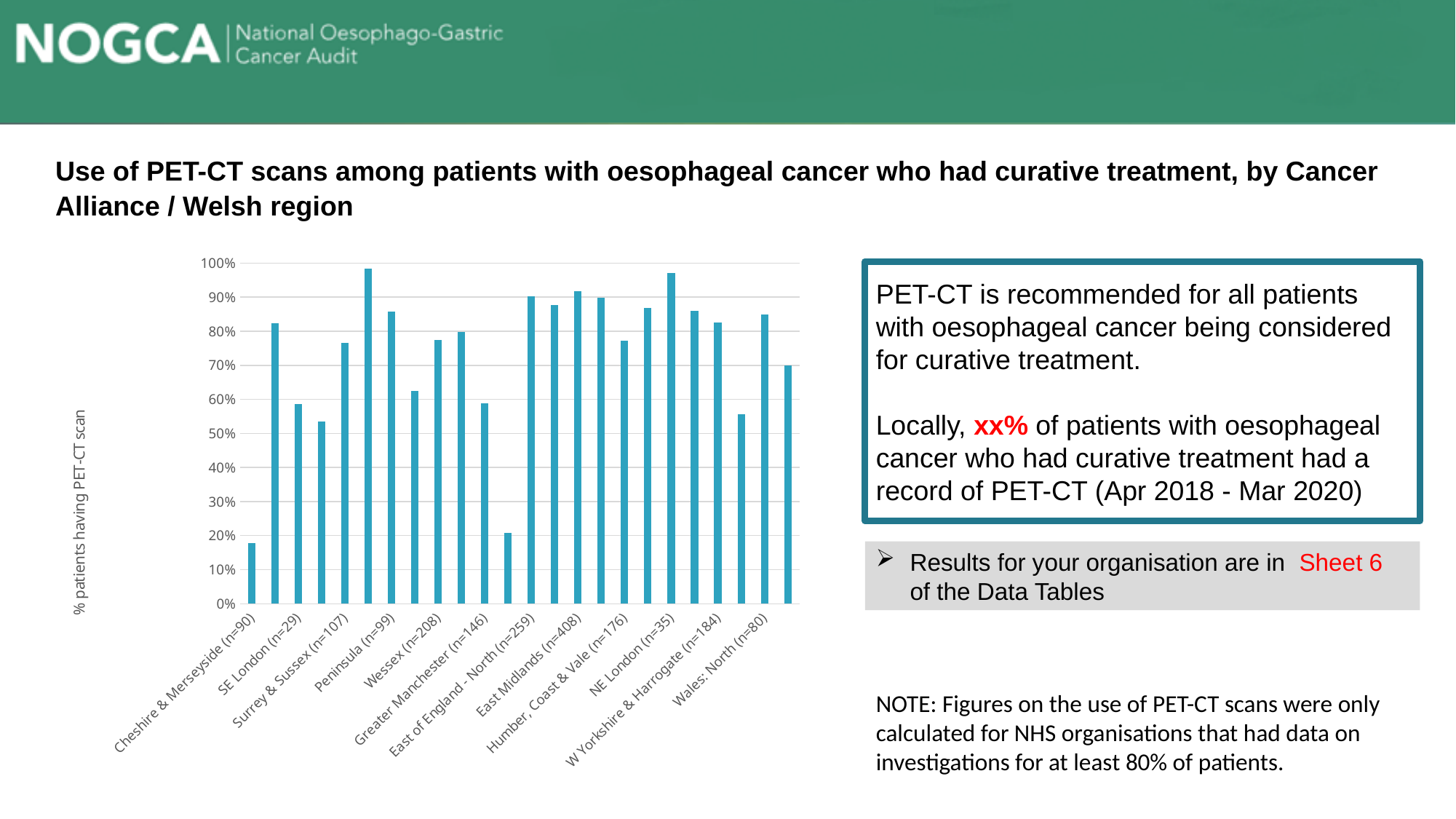
Is the value for Wales: North (n=80) greater or less than 80%? greater How many bars are plotted in the chart? 24 Is the value for NE London (n=35) greater or less than 90%? greater Which has the higher value, NE London (n=35) or Cheshire & Merseyside (n=90)? NE London (n=35) What type of chart is shown on the slide? bar chart What is the label on the vertical axis of the chart? % patients having PET-CT scan Is the value for SE London (n=29) greater or less than 70%? less Which has the higher value, Peninsula (n=99) or SE London (n=29)? Peninsula (n=99)